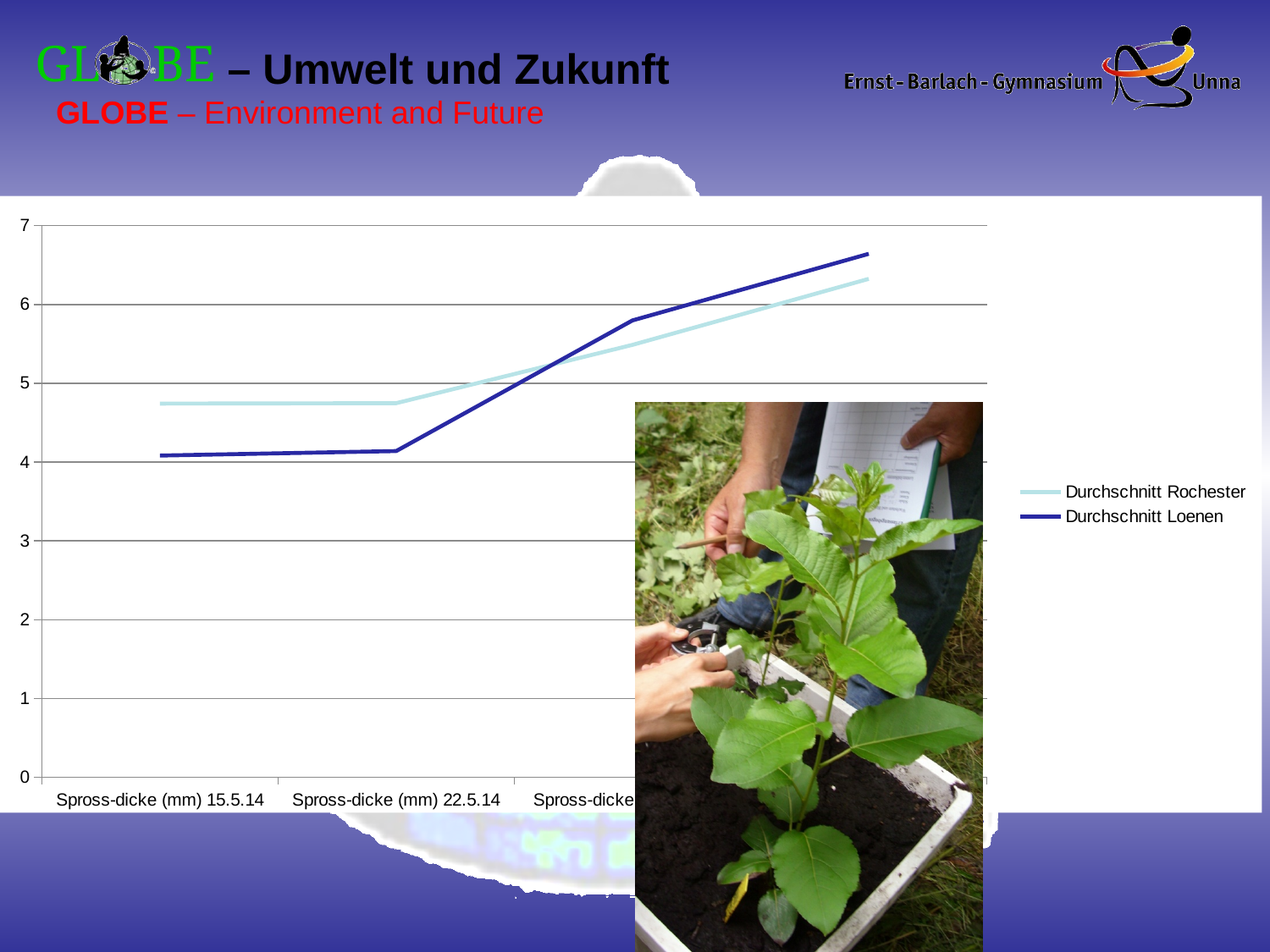
Is the value for Durchschnitt Rochester at Spross-dicke (mm) 15.5.14 greater or less than 4? greater What are the two series named in the legend? Durchschnitt Rochester and Durchschnitt Loenen Which series is drawn in dark blue? Durchschnitt Loenen What kind of chart is shown on the slide? line chart How many series does the legend list? 2 Is the value for Durchschnitt Rochester at Spross-dicke (mm) 22.5.14 greater or less than 5? less Which series reaches the highest value at the right end of the chart? Durchschnitt Loenen Is the value for Durchschnitt Loenen at Spross-dicke (mm) 15.5.14 greater or less than 5? less Do the values for Durchschnitt Loenen rise or fall from left to right along the x axis? rise At Spross-dicke (mm) 15.5.14, which series has the higher value, Durchschnitt Rochester or Durchschnitt Loenen? Durchschnitt Rochester At Spross-dicke (mm) 22.5.14, which series has the lower value, Durchschnitt Rochester or Durchschnitt Loenen? Durchschnitt Loenen